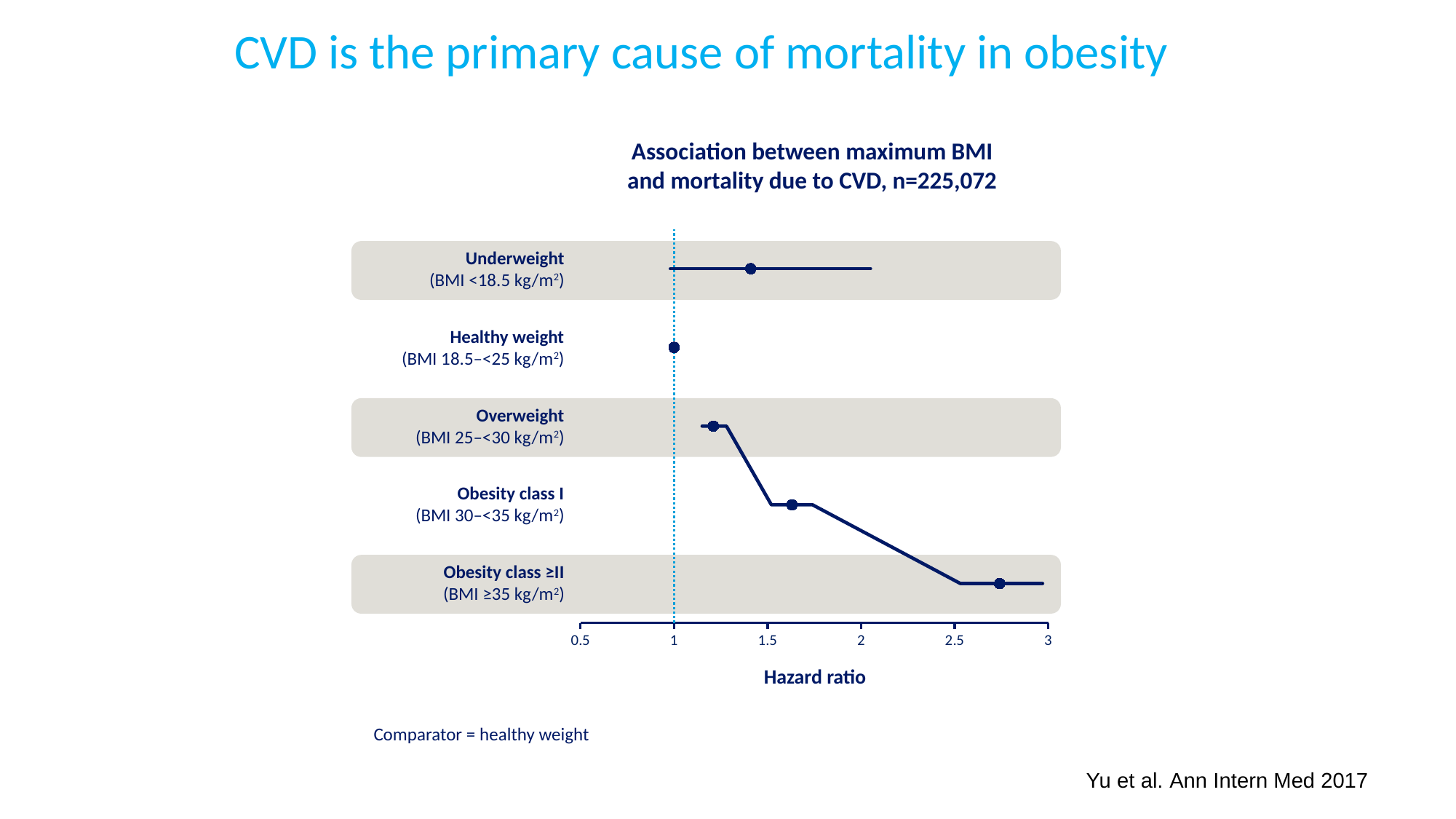
How many BMI groups are shown in the chart? 5 What is the sample size (n) stated in the chart title? 225,072 Is the hazard ratio for Obesity class I greater or less than 1.5? greater What is the hazard ratio for the Healthy weight group? 1 Is the hazard ratio for Overweight greater or less than 1.5? less Is the hazard ratio for Underweight greater or less than 1? greater Which BMI group has the highest hazard ratio for CVD mortality? Obesity class ≥II (BMI ≥35 kg/m²) Which BMI group has the lowest hazard ratio? Healthy weight (BMI 18.5–<25 kg/m²) What is the label of the horizontal axis? Hazard ratio Which has the larger hazard ratio, Overweight or Obesity class I? Obesity class I What kind of chart is shown on the slide? Forest plot (dot plot with confidence intervals)